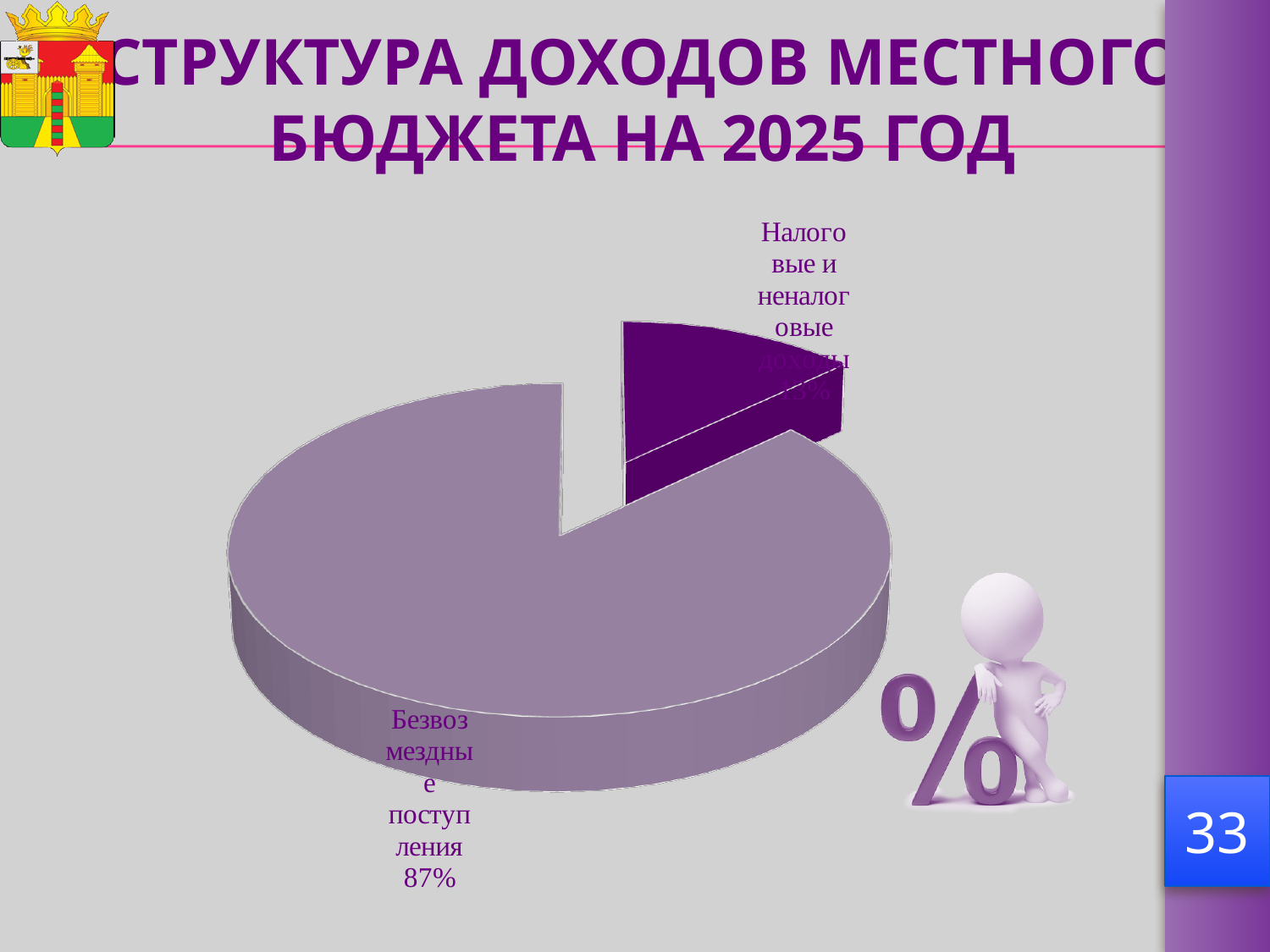
Which slice of the pie chart is the smallest? Налоговые и неналоговые доходы Which slice of the pie chart is the largest? Безвозмездные поступления By how many percentage points does Безвозмездные поступления exceed Налоговые и неналоговые доходы? 74 percentage points Which is larger: Безвозмездные поступления or Налоговые и неналоговые доходы? Безвозмездные поступления What is the title of the slide containing the pie chart? СТРУКТУРА ДОХОДОВ МЕСТНОГО БЮДЖЕТА НА 2025 ГОД What share of the pie is labelled for Налоговые и неналоговые доходы? 13% What share of the pie is labelled for Безвозмездные поступления? 87% What kind of chart is shown on the slide? pie chart What share of the whole pie does the Безвозмездные поступления slice represent? 87% Is the share for Безвозмездные поступления greater or less than 50%? greater How many slices does the pie chart have? 2 Which slice is pulled out (exploded) from the rest of the pie? Налоговые и неналоговые доходы